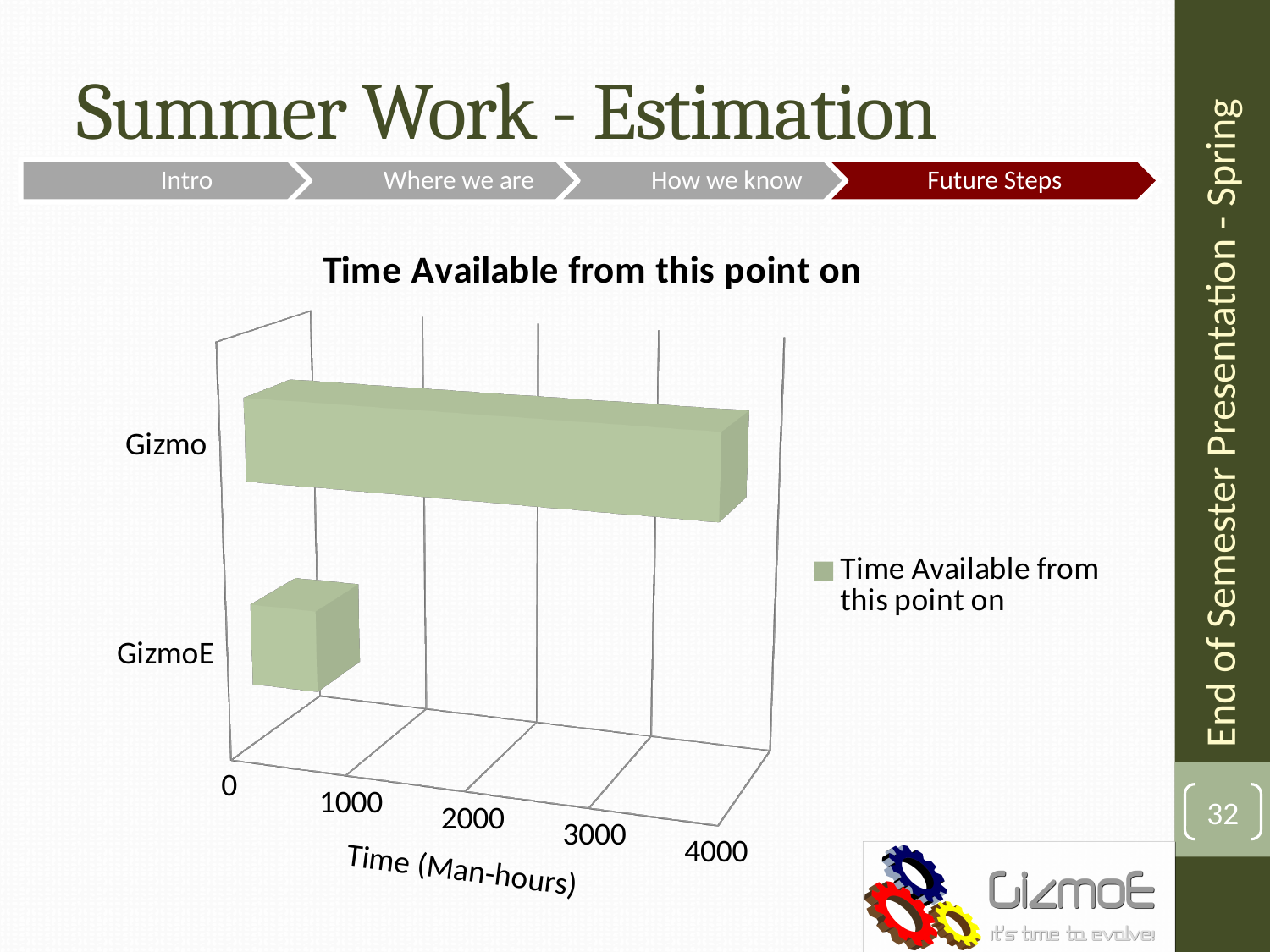
Which category has the lowest value in the chart? GizmoE What is the title of the chart? Time Available from this point on Is the value for Gizmo greater or less than 2000? greater Is the value for Gizmo greater or less than 3000? greater How many series does the chart legend list? 1 What is the label of the horizontal value axis of the chart? Time (Man-hours) Is the value for GizmoE greater or less than 1000? less What type of chart is shown on the slide? Bar chart How many categories are plotted in the chart? 2 Which has a larger value, Gizmo or GizmoE? Gizmo Which category has the highest value in the chart? Gizmo